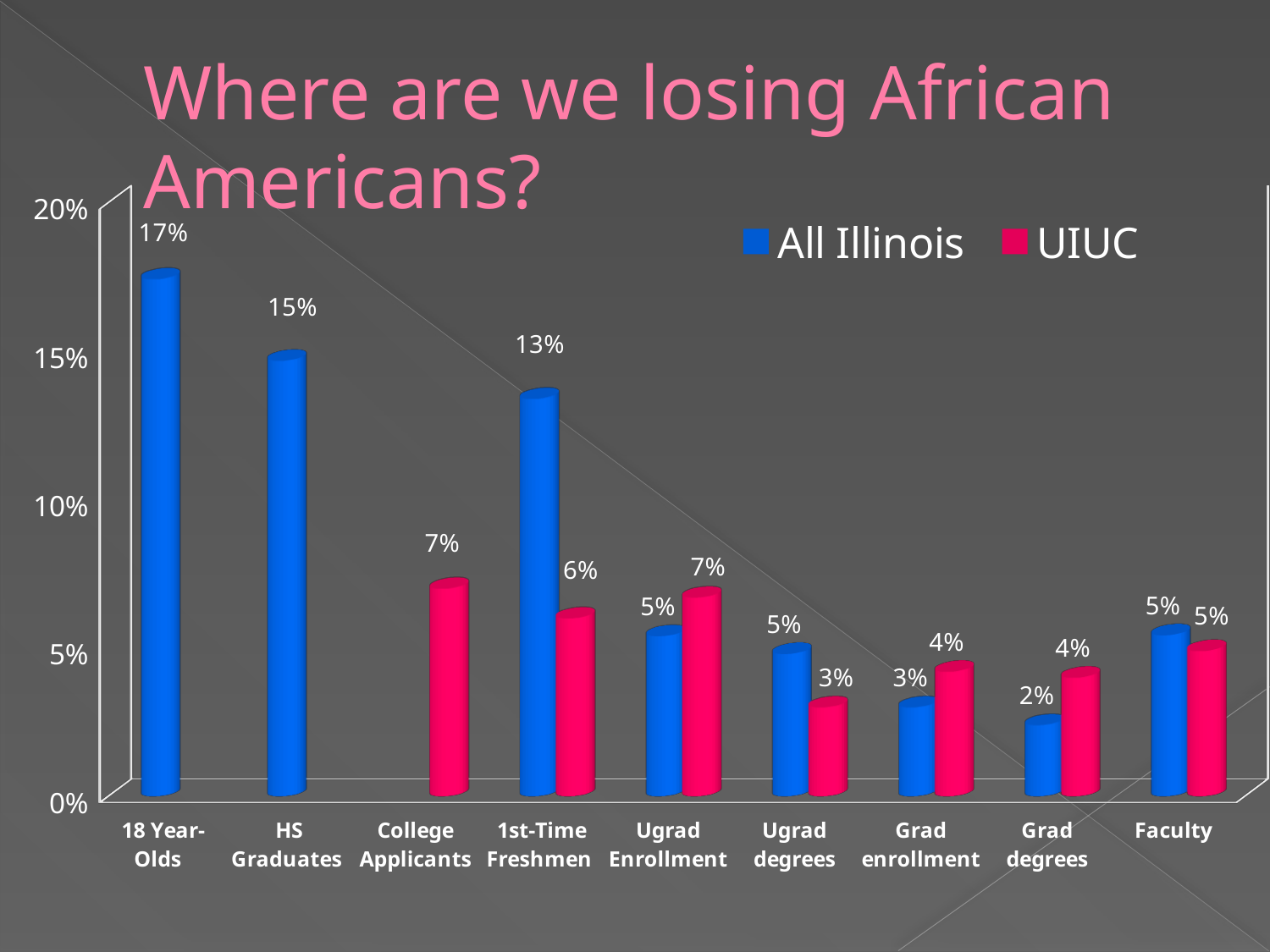
Which series is shown in blue? All Illinois What is the UIUC value for College Applicants? 7% For Ugrad Enrollment, which is larger: the All Illinois value or the UIUC value? UIUC What is the UIUC value for 1st-Time Freshmen? 6% What is the All Illinois value for Grad degrees? 2% What kind of chart is shown on the slide? Bar chart What is the All Illinois value for 18 Year-Olds? 17% Which category has the highest All Illinois value? 18 Year-Olds How many categories are shown on the x axis? 9 How many series does the legend list? 2 Which category has the lowest All Illinois value? Grad degrees What is the difference between the All Illinois and UIUC values for 1st-Time Freshmen? 7%